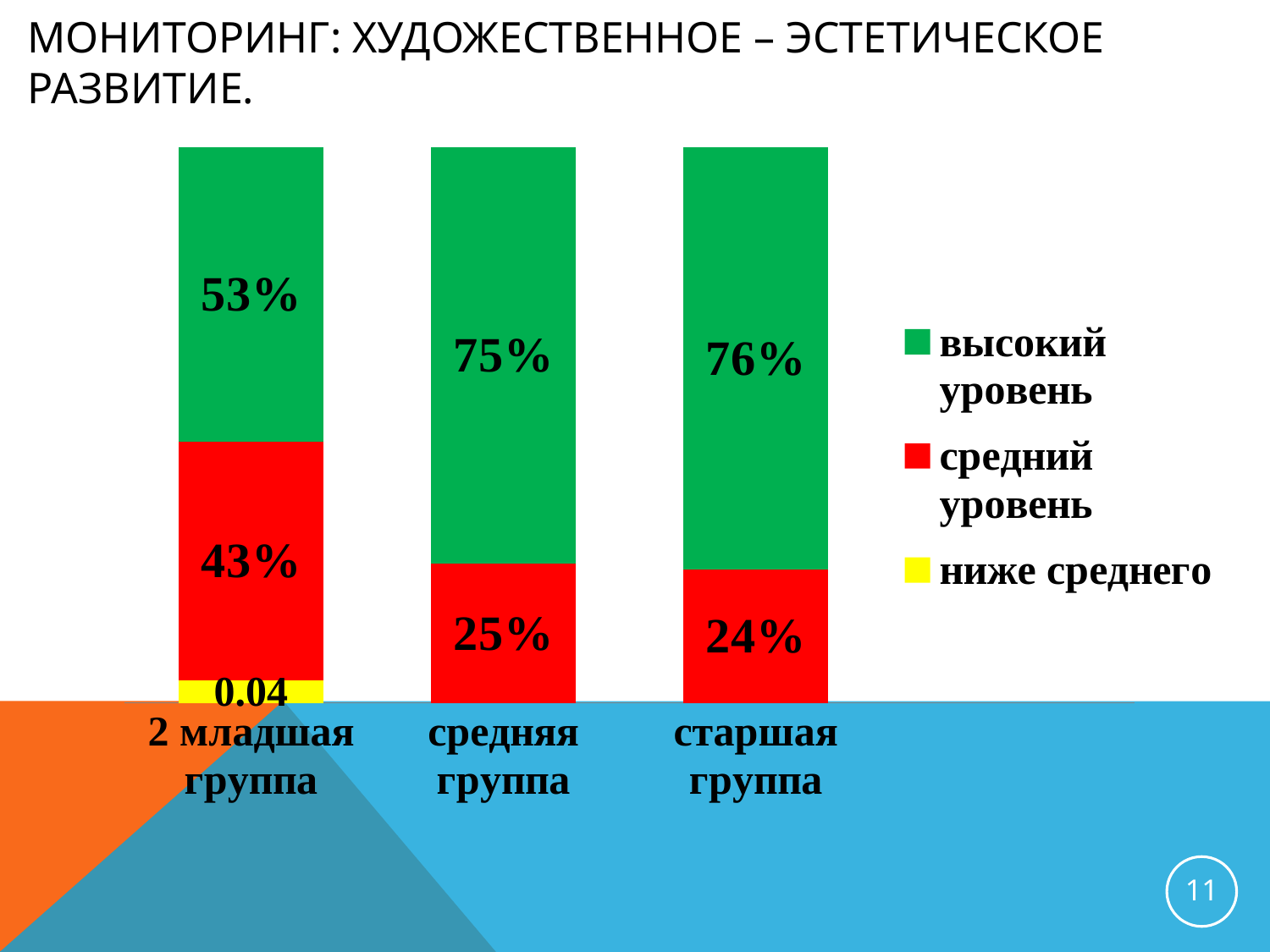
Which group has the lowest value for высокий уровень? 2 младшая группа Which is larger: средний уровень for 2 младшая группа or for средняя группа? 2 младшая группа Which colour represents средний уровень in the legend? red Which group has the highest value for высокий уровень? старшая группа What is the value of высокий уровень for средняя группа? 75% What label is printed on the ниже среднего segment for 2 младшая группа? 0.04 How many series does the legend list? 3 What is the value of средний уровень for старшая группа? 24% What type of chart is shown on the slide? stacked bar chart What is the difference between the высокий уровень values for старшая группа and 2 младшая группа? 23% How many groups (categories) are shown on the x axis? 3 What is the value of высокий уровень for 2 младшая группа? 53%